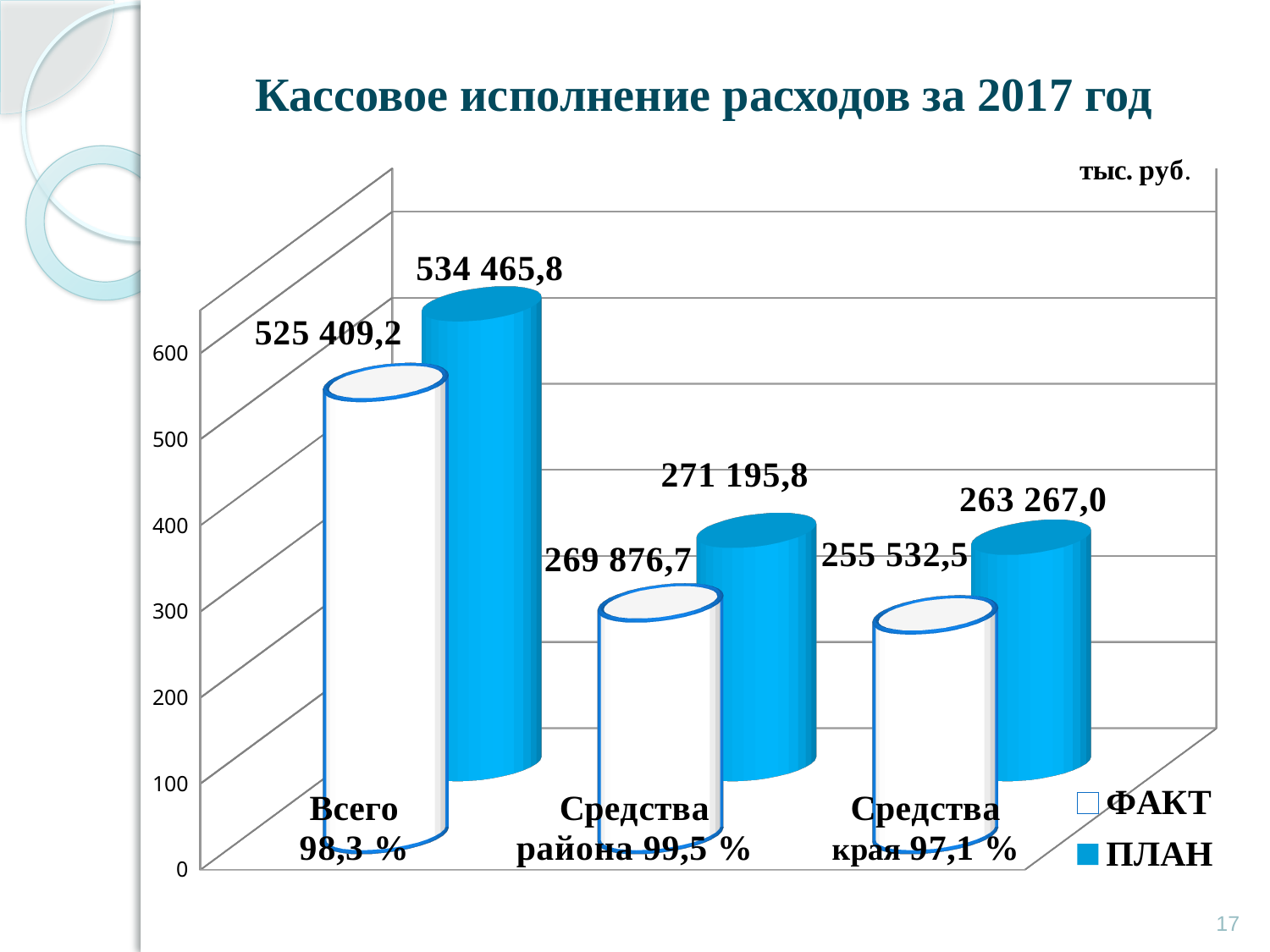
Which category has the lowest ПЛАН value? Средства края Which is larger for Средства района: the ПЛАН value or the ФАКТ value? ПЛАН What is the ФАКТ value for Средства края? 255 532,5 What is the ПЛАН value for Всего? 534 465,8 What is the ФАКТ value for Средства района? 269 876,7 What kind of chart is shown on the slide? Bar chart How many series does the legend list? 2 What is the difference between the ПЛАН and ФАКТ values for Средства края? 7 734,5 What is the ПЛАН value for Средства края? 263 267,0 What is the difference between the ПЛАН and ФАКТ values for Всего? 9 056,6 How many categories are shown on the x axis? 3 Which category has the highest ФАКТ value? Всего